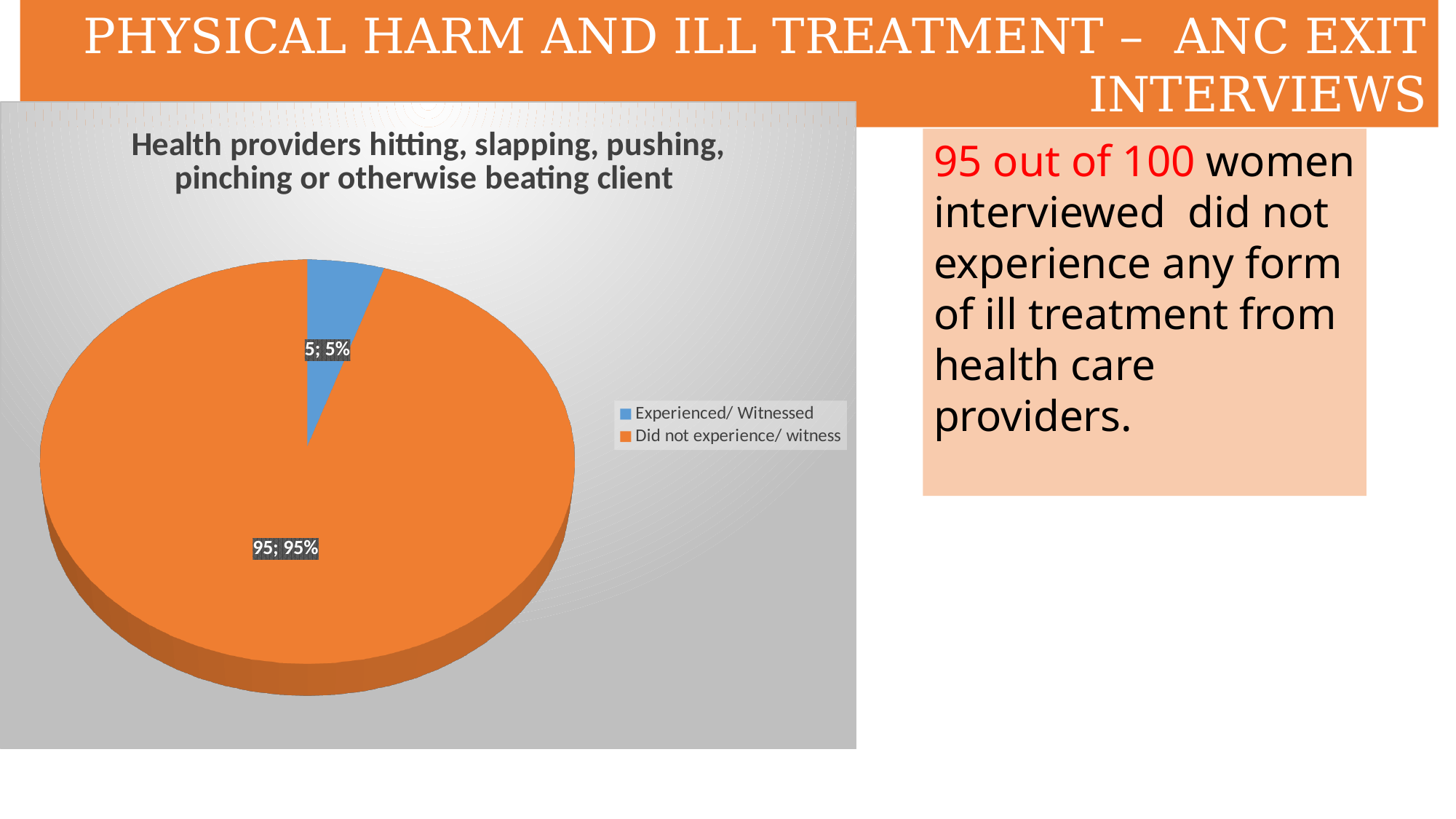
How many entries does the legend list? 2 What is the title of the chart? Health providers hitting, slapping, pushing, pinching or otherwise beating client What share of the pie does the 'Experienced/ Witnessed' slice represent? 5% What value is shown for the 'Experienced/ Witnessed' slice? 5 Which slice is the largest? Did not experience/ witness What is the difference between the 'Did not experience/ witness' value and the 'Experienced/ Witnessed' value? 90 How many slices does the pie chart have? 2 What type of chart is shown on the slide? Pie chart What share of the pie does the 'Did not experience/ witness' slice represent? 95% Which slice is the smallest? Experienced/ Witnessed What value is shown for the 'Did not experience/ witness' slice? 95 What colour is the 'Experienced/ Witnessed' slice? Blue